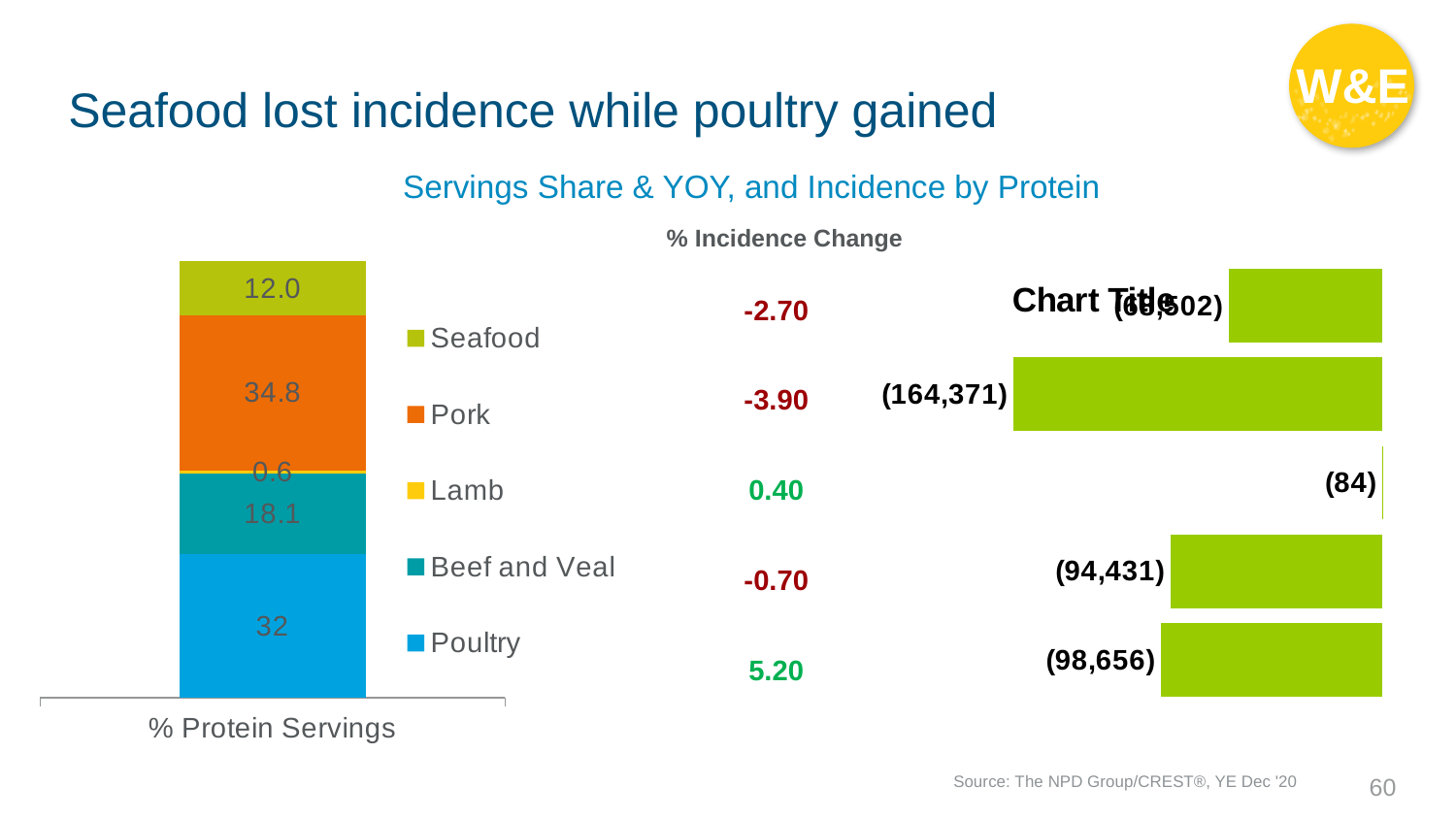
In the stacked bar chart on the left (% Protein Servings), which protein has the smallest share? Lamb In the stacked bar chart on the left (% Protein Servings), what is the value for Poultry? 32 In the stacked bar chart on the left (% Protein Servings), what is the value for Lamb? 0.6 In the stacked bar chart on the left (% Protein Servings), what is the value for Pork? 34.8 In the bar chart on the right, what is the data label on the second bar from the top? (164,371) In the % Incidence Change column, what is the value shown for Poultry? 5.20 In the % Incidence Change column, what is the value shown for Pork? -3.90 What type of chart is the chart on the left (% Protein Servings)? Stacked bar chart In the stacked bar chart on the left (% Protein Servings), which is larger, Beef and Veal or Seafood? Beef and Veal In the stacked bar chart on the left (% Protein Servings), what is the difference between the Pork and Seafood values? 22.8 How many entries does the legend of the stacked bar chart on the left list? 5 In the stacked bar chart on the left (% Protein Servings), which protein has the largest share? Pork